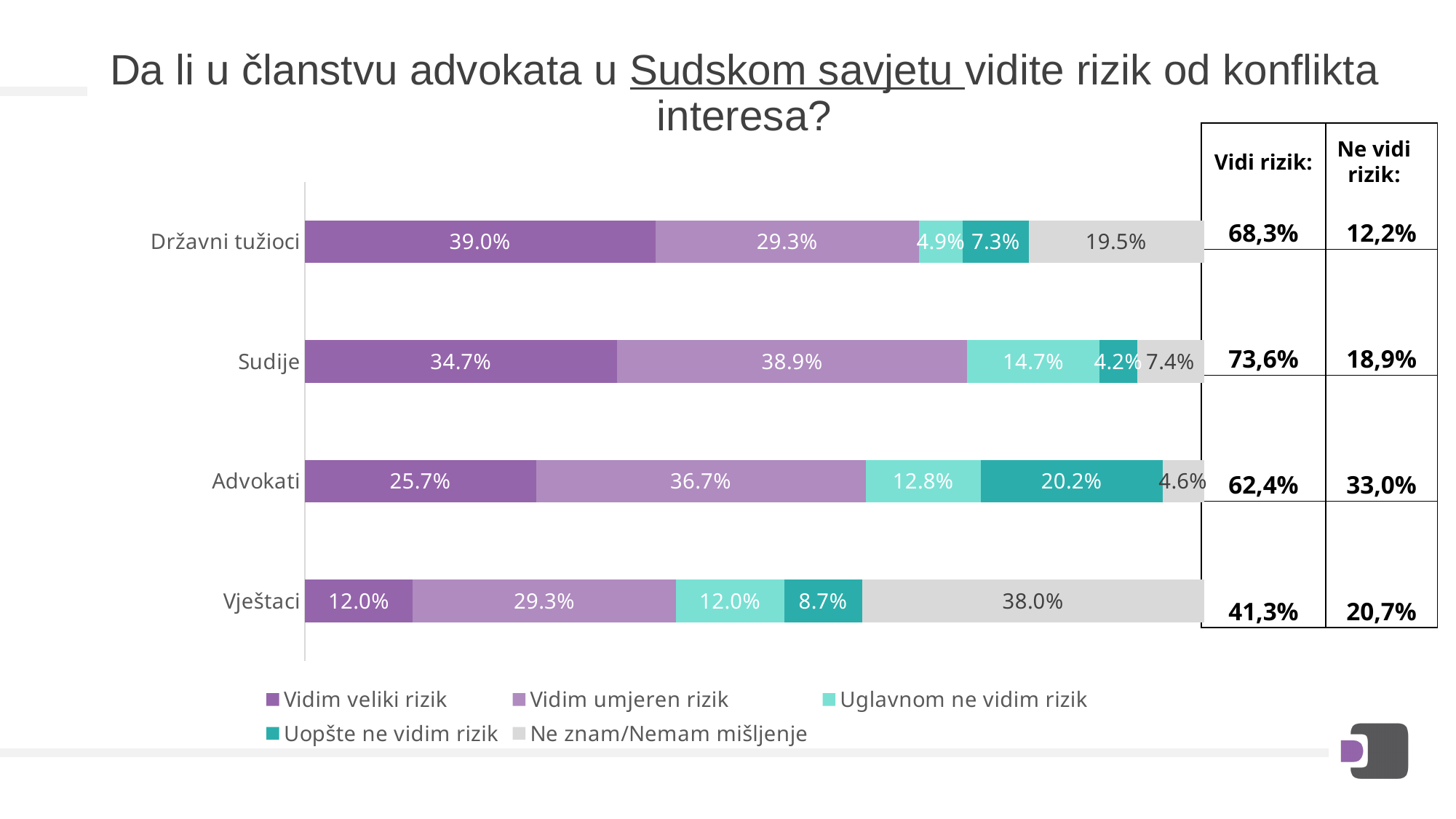
Which category has the lowest value for 'Ne znam/Nemam mišljenje'? Advokati Which category has the highest value for 'Vidim veliki rizik'? Državni tužioci What is the value of 'Ne znam/Nemam mišljenje' for Vještaci? 38.0% How many series does the legend list? 5 What kind of chart is shown on the slide? Stacked bar chart What is the value of 'Uopšte ne vidim rizik' for Advokati? 20.2% How many categories (respondent groups) are plotted on the chart? 4 What is the value of 'Vidim veliki rizik' for Državni tužioci? 39.0% What is the difference between the 'Vidim veliki rizik' values for Sudije and Vještaci? 22.7% According to the table on the right, what is the 'Vidi rizik' value for Sudije? 73,6% Which is larger: the 'Uglavnom ne vidim rizik' value for Sudije or for Advokati? Sudije What is the value of 'Vidim umjeren rizik' for Sudije? 38.9%